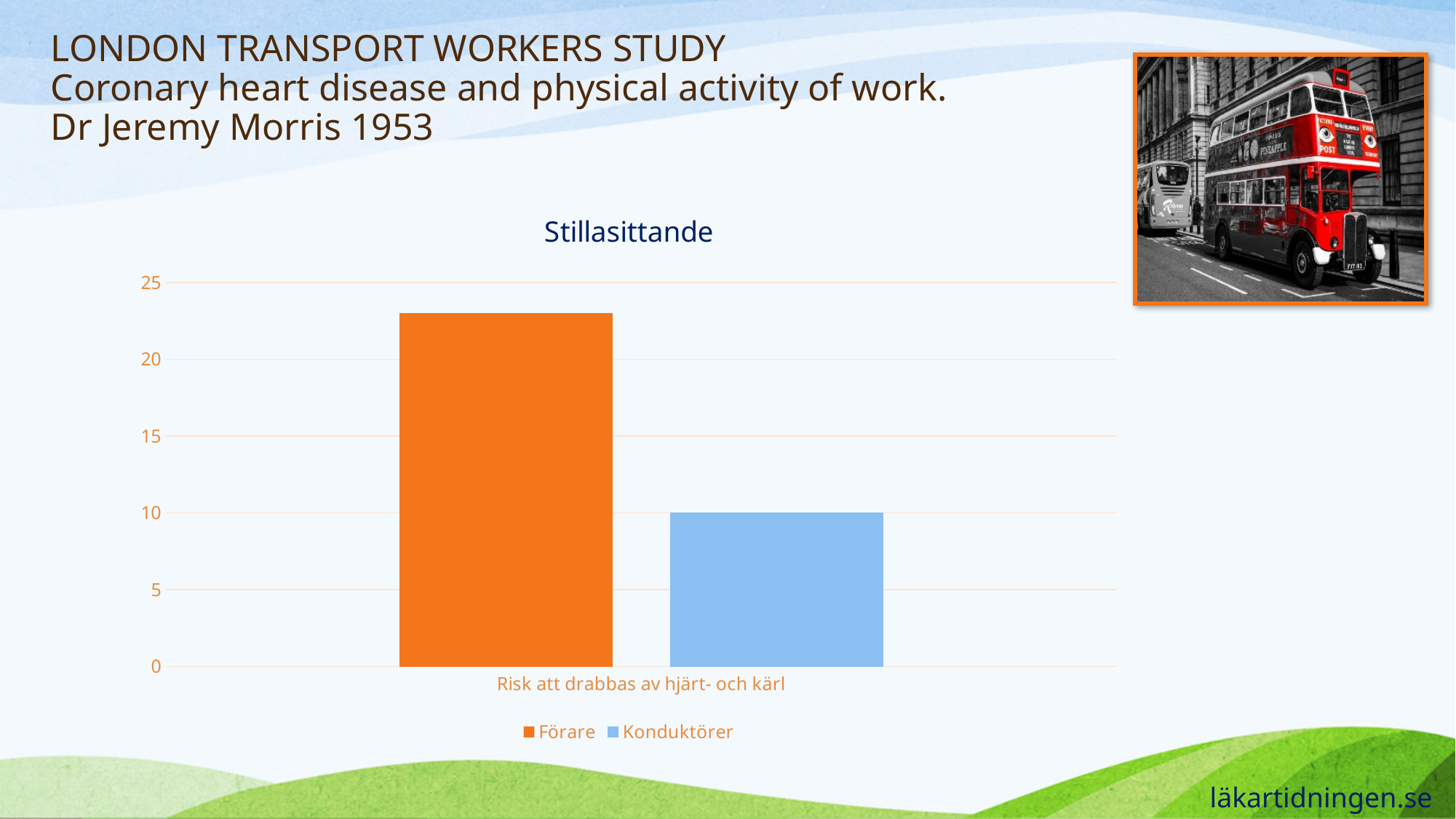
Which colour represents the Förare series? orange Is the value for Konduktörer greater or less than 15? less Is the value for Förare larger or smaller than the value for Konduktörer? larger What is the title of the chart? Stillasittande Is the value for Förare greater or less than 20? greater What kind of chart is shown on the slide? bar chart Which series has the higher value for 'Risk att drabbas av hjärt- och kärl'? Förare Which series has the lower value for 'Risk att drabbas av hjärt- och kärl'? Konduktörer What is the value for Konduktörer? 10 How many categories are shown on the x axis? 1 How many series does the legend list? 2 Is the value for Förare greater or less than 25? less